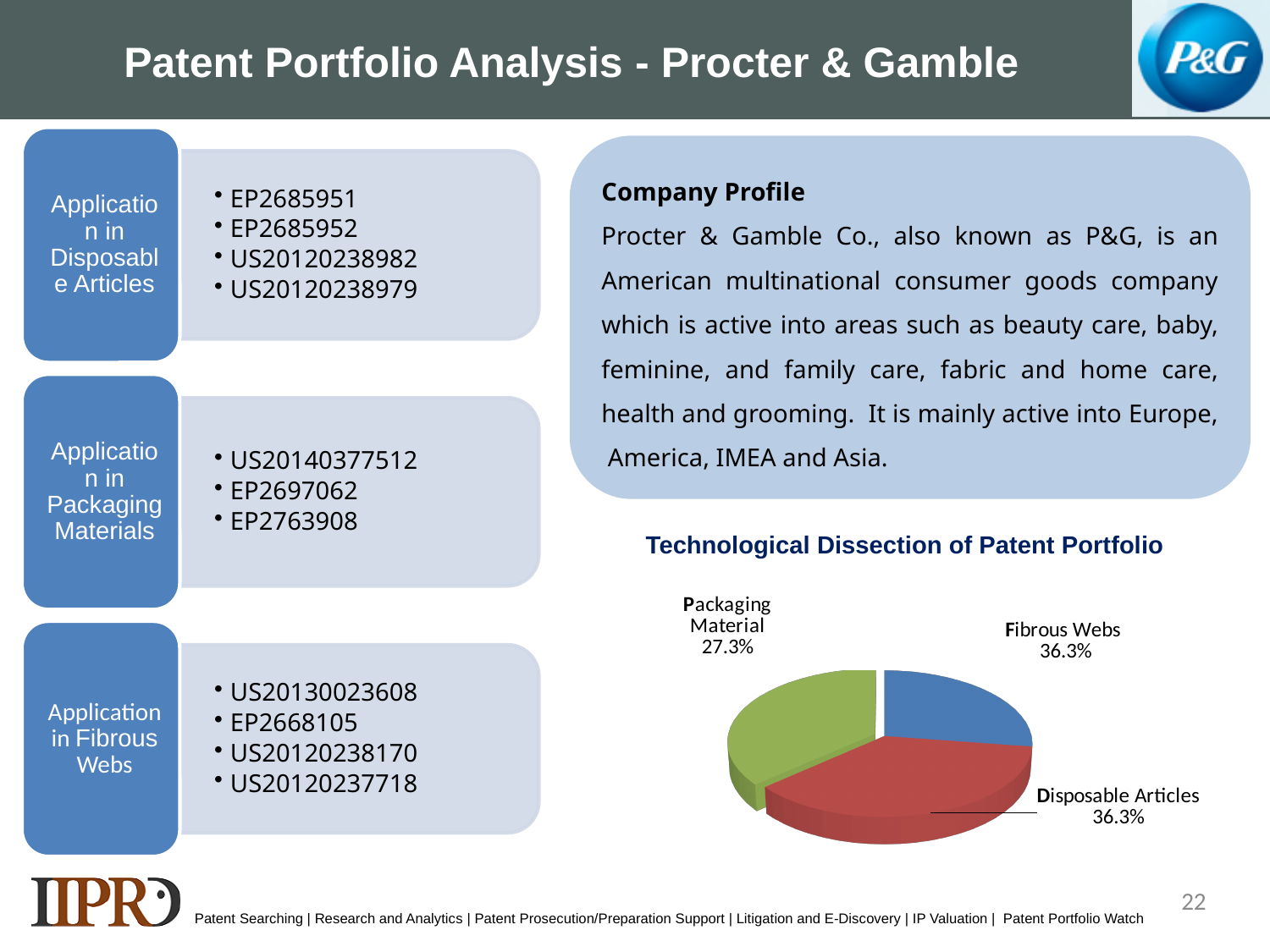
What is the title of the pie chart on the slide? Technological Dissection of Patent Portfolio What share of the patent portfolio does Packaging Material represent in the pie chart? 27.3% How many slices does the pie chart have? 3 Which category has the smallest slice in the pie chart? Packaging Material Which is larger in the pie chart, Packaging Material or Fibrous Webs? Fibrous Webs Do Fibrous Webs and Disposable Articles have the same share in the pie chart? Yes, both 36.3% What colour is the Disposable Articles slice in the pie chart? Red What type of chart is shown under the title "Technological Dissection of Patent Portfolio"? Pie chart Which is larger in the pie chart, Disposable Articles or Packaging Material? Disposable Articles What share of the patent portfolio does Fibrous Webs represent in the pie chart? 36.3% What is the difference between the Fibrous Webs share and the Packaging Material share in the pie chart? 9.0 percentage points What share of the patent portfolio does Disposable Articles represent in the pie chart? 36.3%